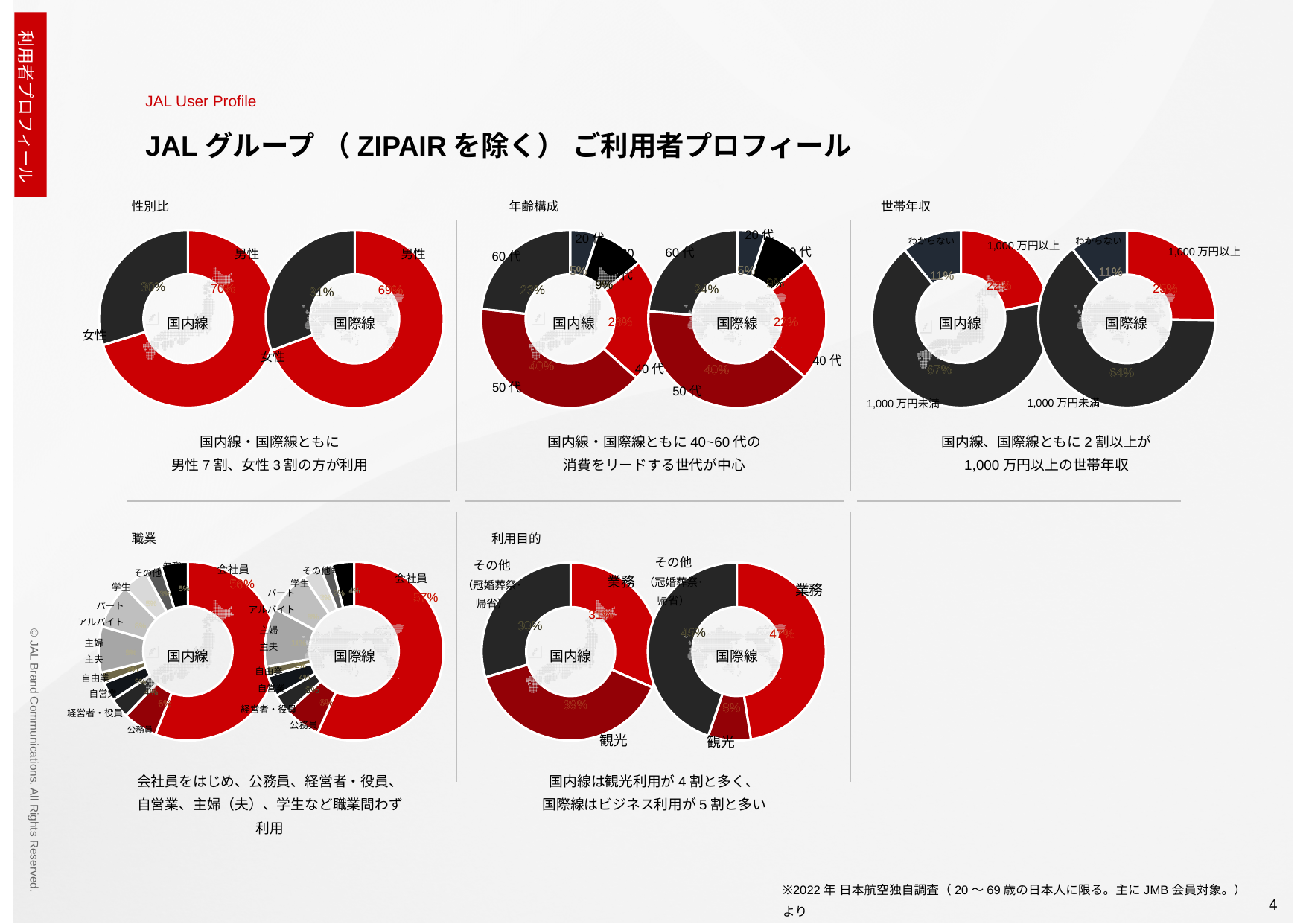
In the 世帯年収 chart for 国内線, what percentage is 1,000万円未満? 67% In the 性別比 chart for 国際線, what percentage is 女性? 31% In the 性別比 chart for 国内線, what percentage is 男性? 70% In the 世帯年収 chart for 国内線, what percentage is わからない? 11% What kind of chart is used throughout this slide? Pie (donut) chart In the 利用目的 chart for 国内線, what percentage is 観光? 39% In the 利用目的 chart for 国際線, what percentage is 業務? 47% In the 年齢構成 chart for 国際線, which age group has the largest share? 50代 In the 世帯年収 chart for 国際線, what percentage is 1,000万円未満? 64% In the 年齢構成 chart for 国内線, what percentage is 50代? 40% In the 利用目的 chart for 国際線, which purpose has the smallest share? 観光 In the 性別比 chart for 国内線, what is the difference between 男性 and 女性? 40%